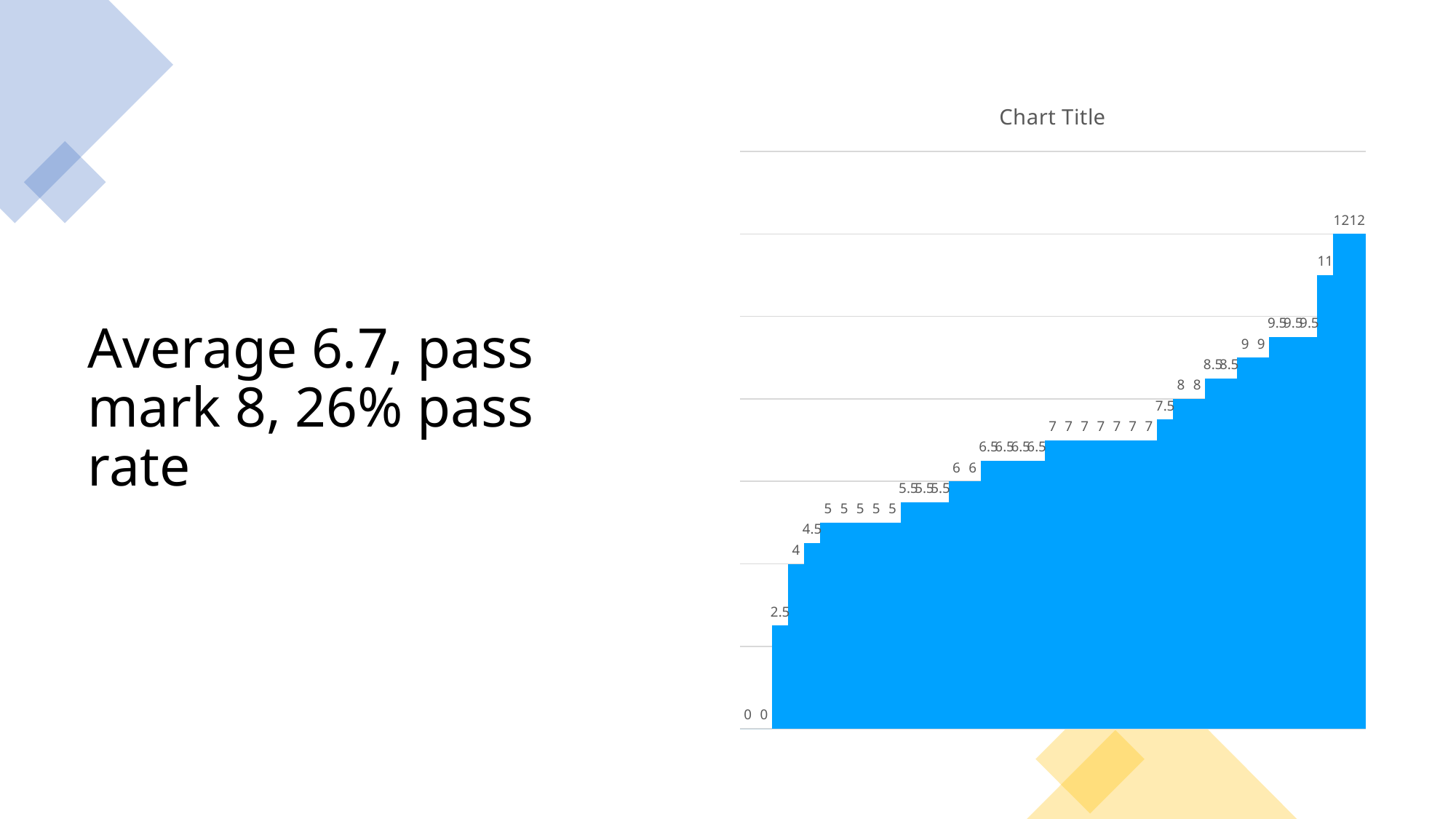
What is the lowest value shown by a data label on the chart? 0 What is the value of the third bar from the left on the chart? 2.5 What is the title of the chart? Chart Title What is the value of the bar immediately to the left of the two tallest bars? 11 What kind of chart is shown on the slide? bar chart What is the highest value shown by a data label on the chart? 12 Which is larger: the value of the bar labelled 7.5 or the bar labelled 8.5? 8.5 What is the difference between the highest data label (12) and the data label 11 next to it? 1 Do the bar values rise or fall from left to right across the chart? rise How many bars on the chart are labelled with the value 7? 7 What colour are the bars on the chart? blue What is the value of the tallest bar on the chart? 12